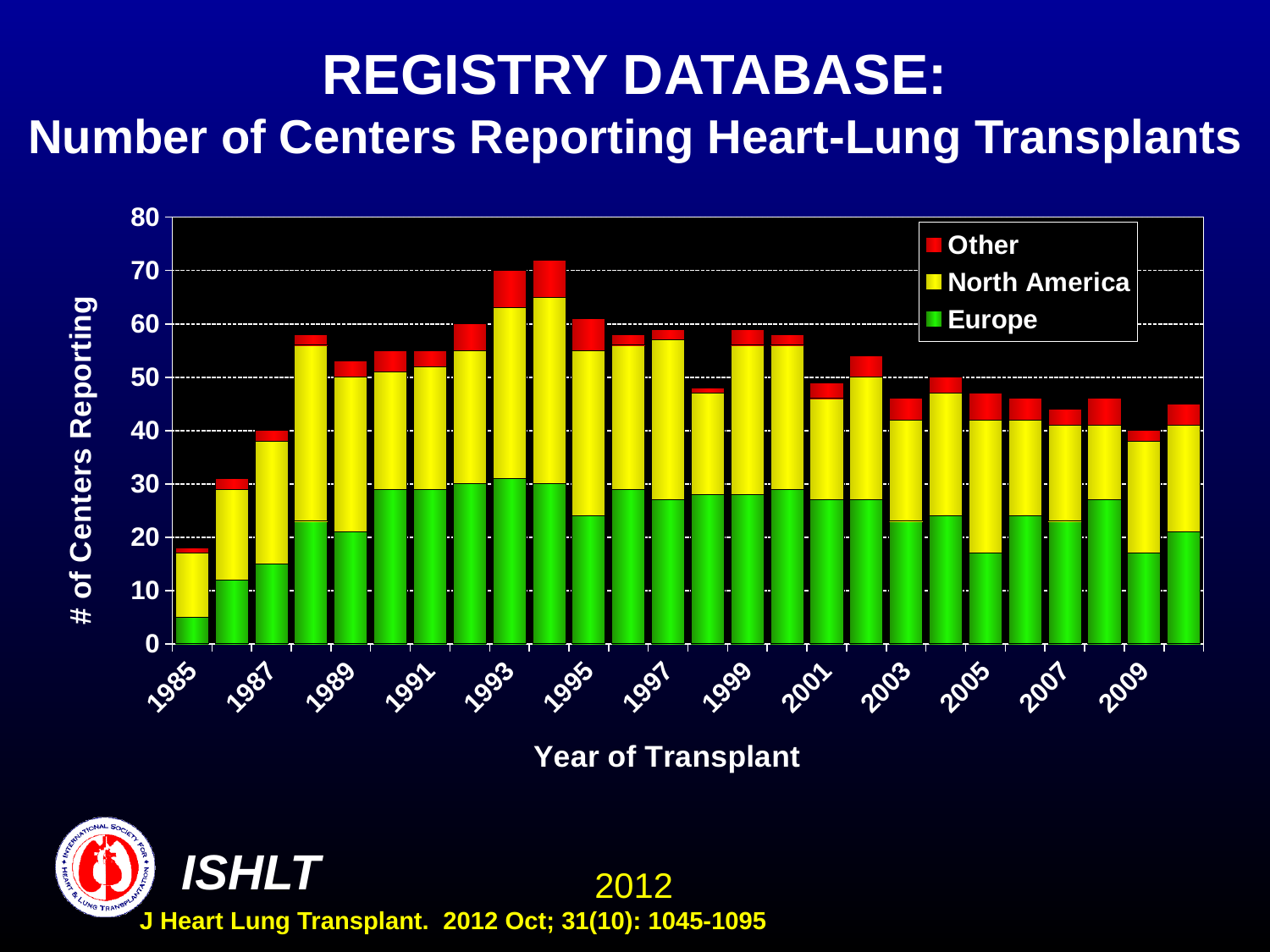
Which year has a larger total number of centers reporting, 1993 or 2009? 1993 How many years (bars) are plotted on the chart? 26 What is the title of the y axis? # of Centers Reporting What kind of chart is shown on the slide? bar chart Which series is shown in green? Europe Do the total numbers of centers reporting rise or fall from 1985 to 1988? rise Is the total number of centers reporting in 1993 greater or less than 60? greater Which year has the lowest total number of centers reporting? 1985 Is the Europe value for 1985 greater or less than 10? less Is the total number of centers reporting in 1985 greater or less than 20? less How many series does the legend list? 3